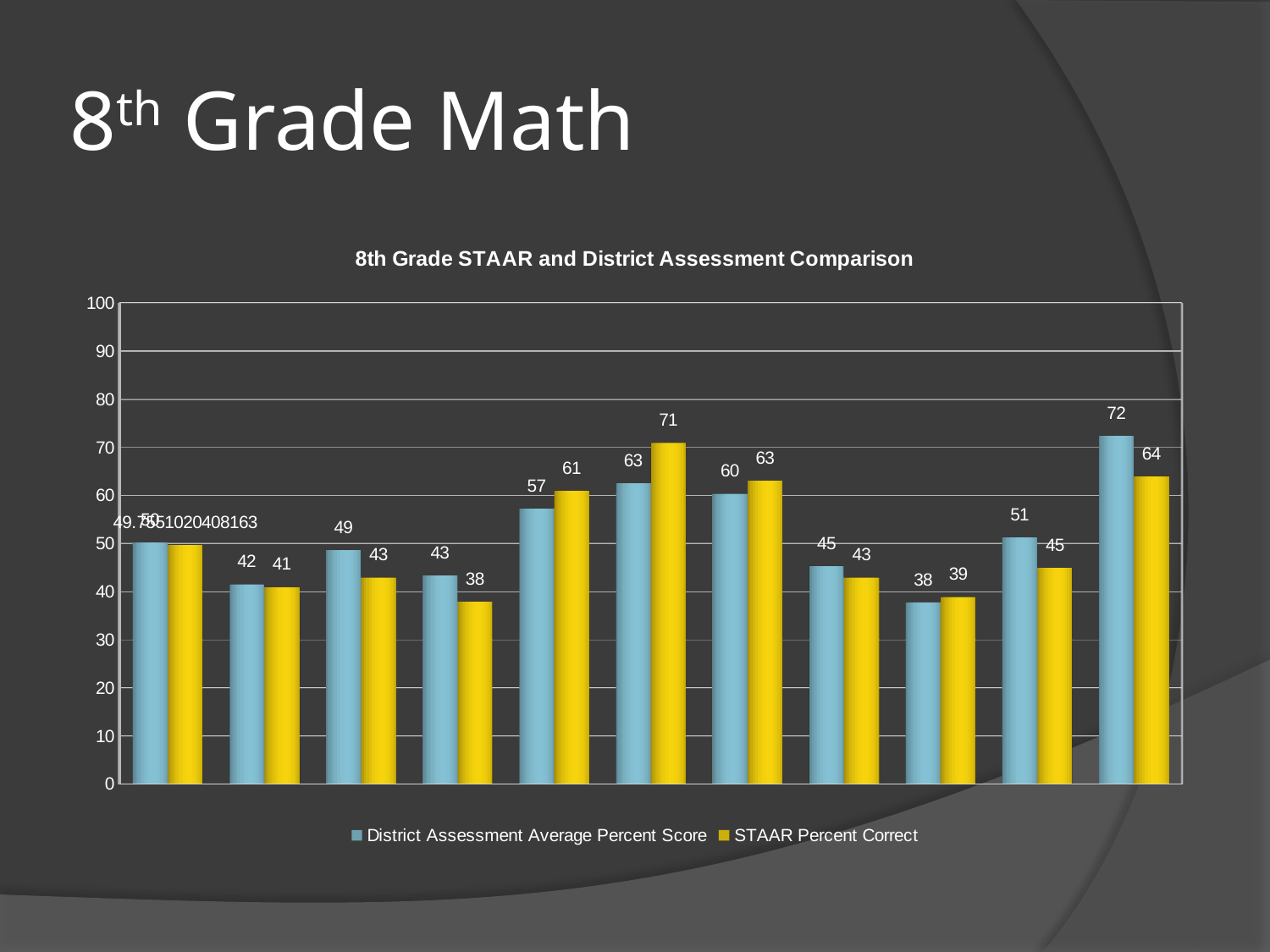
Which series is shown in yellow? STAAR Percent Correct What is the highest District Assessment Average Percent Score shown in the chart? 72 What is the lowest STAAR Percent Correct value shown in the chart? 38 In the rightmost group of bars, what is the difference between the District Assessment Average Percent Score and the STAAR Percent Correct? 8 What type of chart is shown on the slide? bar chart Is the District Assessment Average Percent Score for the rightmost group greater or less than 70? greater In the sixth group of bars from the left, which is larger: the District Assessment Average Percent Score or the STAAR Percent Correct? STAAR Percent Correct How many groups of bars are plotted in the chart? 11 What is the STAAR Percent Correct value for the rightmost group of bars? 64 How many series does the legend list? 2 What is the title of the chart? 8th Grade STAAR and District Assessment Comparison What is the highest STAAR Percent Correct value shown in the chart? 71